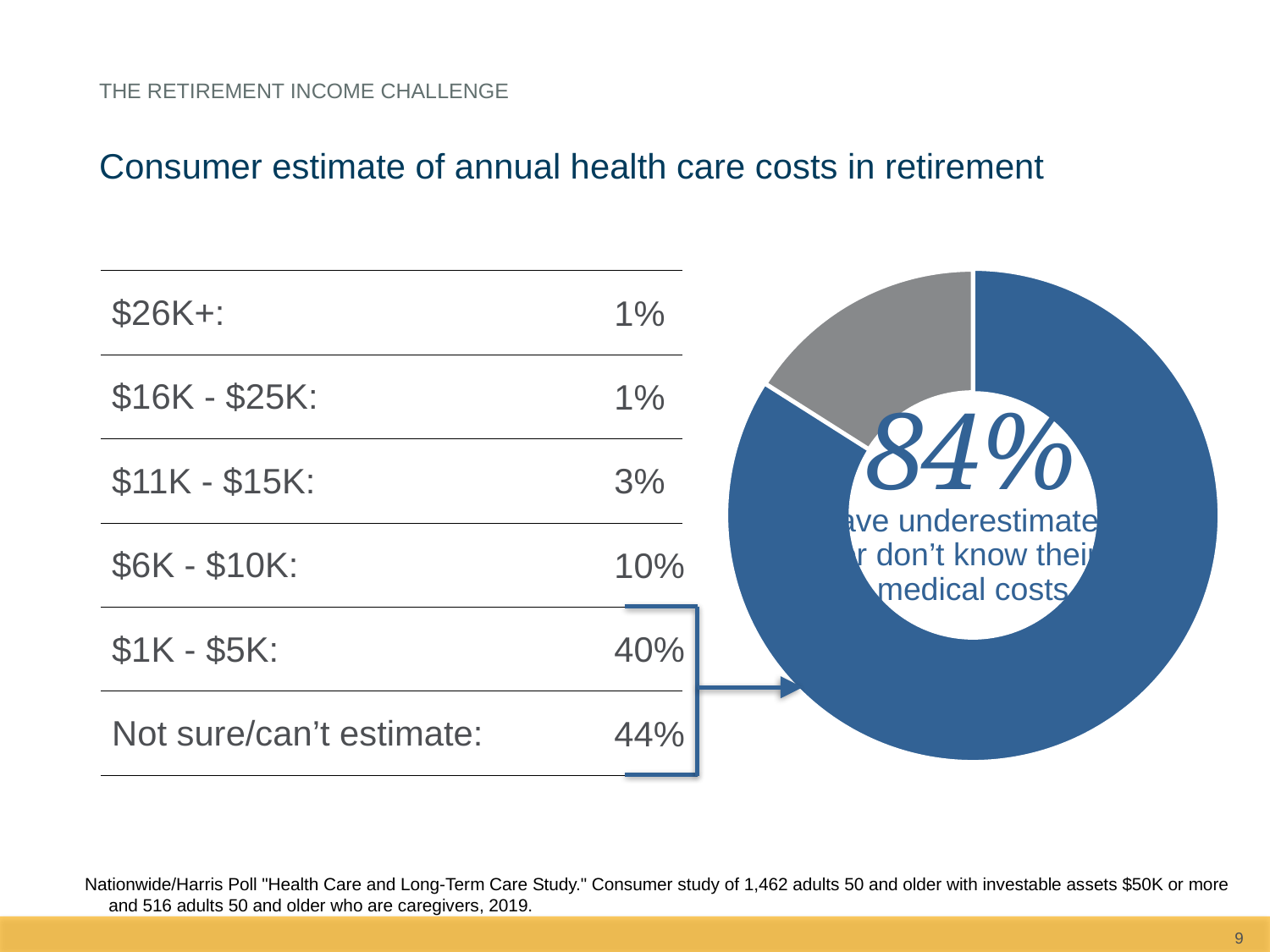
What is the total of the two bracketed table values ("$1K - $5K" and "Not sure/can't estimate") that make up the 84% slice? 84% Which slice of the donut chart is larger, the blue one or the grey one? Blue What is the title of the slide's chart section? Consumer estimate of annual health care costs in retirement How many slices does the donut chart have? 2 What share of the donut chart does the blue slice represent? 84% In the table next to the chart, what percentage is shown for "$1K - $5K"? 40% In the table next to the chart, which category has the highest percentage? Not sure/can't estimate What colour is the larger slice of the donut chart? Blue What percentage is printed in the centre of the donut chart? 84% What kind of chart is shown on the right of the slide? Donut (pie) chart Is the blue slice of the donut chart greater or less than 50% of the whole? greater In the table next to the chart, what percentage is shown for "Not sure/can't estimate"? 44%